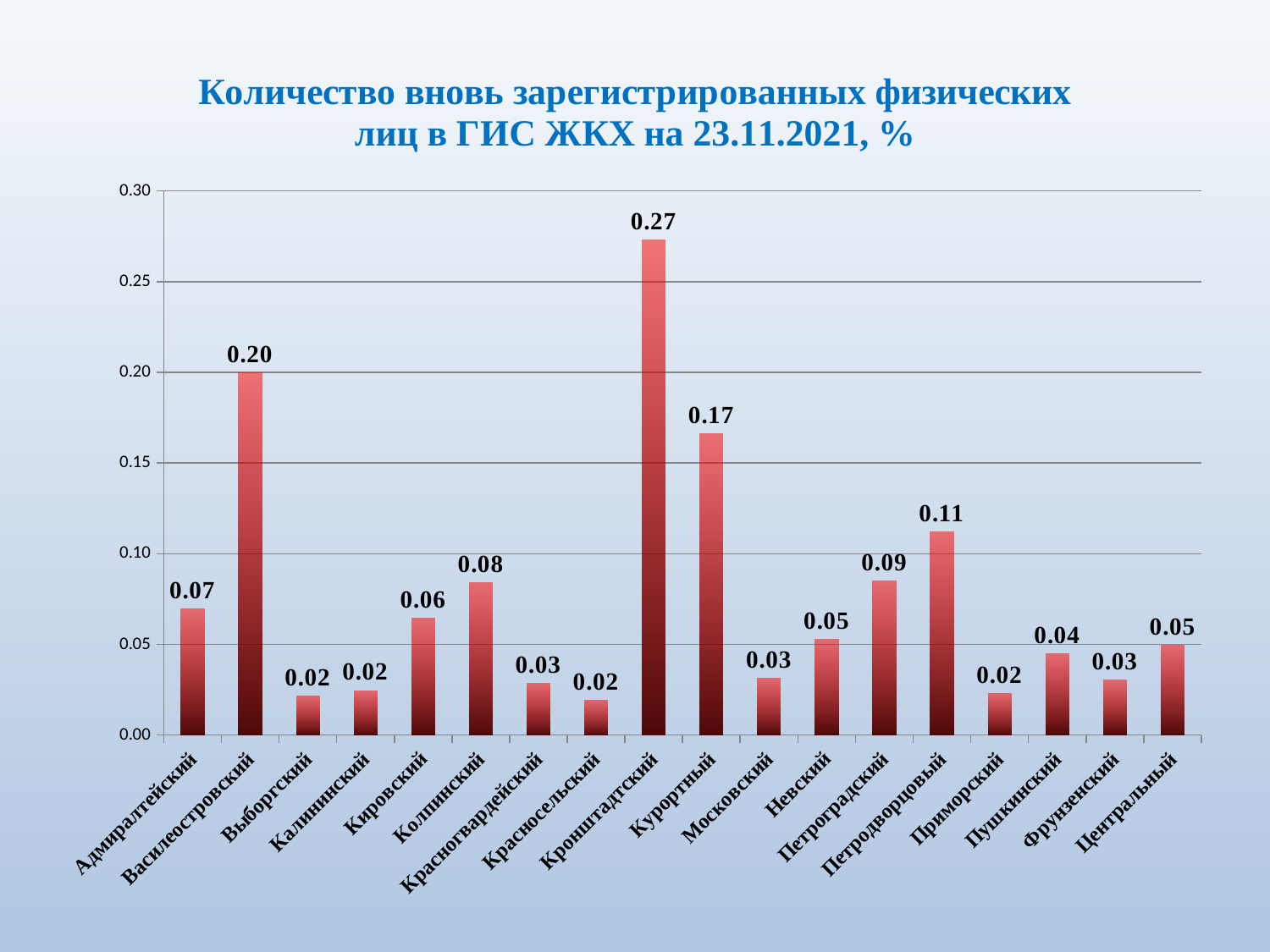
What is the value for Кронштадтский? 0.27 What kind of chart is shown on the slide? bar chart What date is given in the chart title? 23.11.2021 What is the value for Петродворцовый? 0.11 Which is larger, the value for Курортный or the value for Петродворцовый? Курортный What is the difference between the values for Кронштадтский and Василеостровский? 0.07 What is the value for Василеостровский? 0.20 What is the difference between the values for Курортный and Петроградский? 0.08 Which district has the highest value? Кронштадтский What is the value for Пушкинский? 0.04 Is the value for Кронштадтский greater or less than 0.25? greater How many districts are shown on the x axis? 18